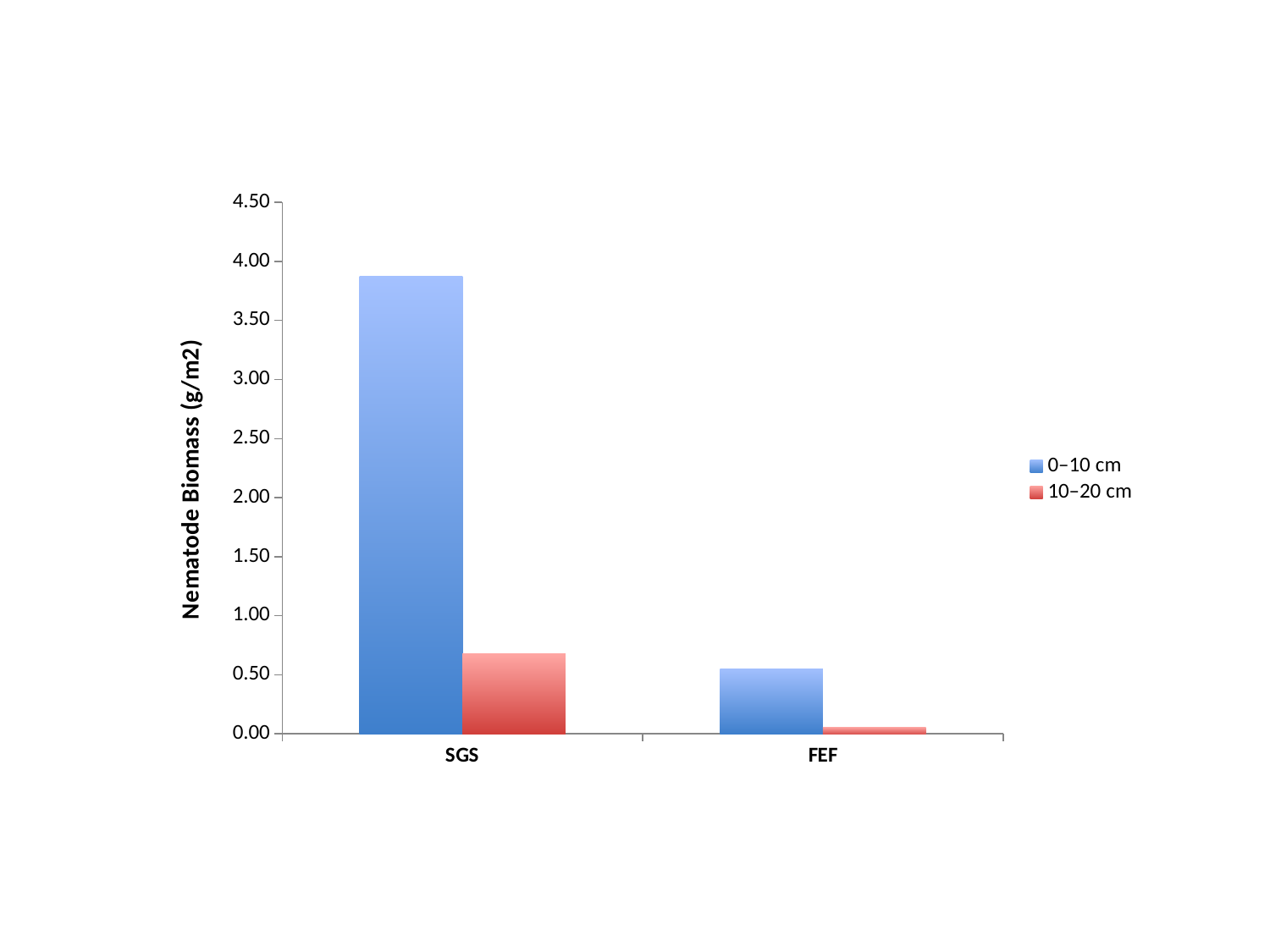
Is the 0–10 cm value for FEF greater or less than 1.00? less Which category has the lowest 10–20 cm nematode biomass? FEF Which category has the highest 0–10 cm nematode biomass? SGS What kind of chart is shown on the slide? bar chart How many series does the legend list? 2 Is the 10–20 cm value for SGS greater or less than 1.00? less What is the label of the y axis? Nematode Biomass (g/m2) Is the 0–10 cm value for SGS greater or less than 3.50? greater Which is larger for SGS: the 0–10 cm value or the 10–20 cm value? 0–10 cm How many categories are shown on the x axis? 2 Which is larger: the 10–20 cm value for SGS or the 0–10 cm value for FEF? 10–20 cm value for SGS What colour represents the 10–20 cm series? red